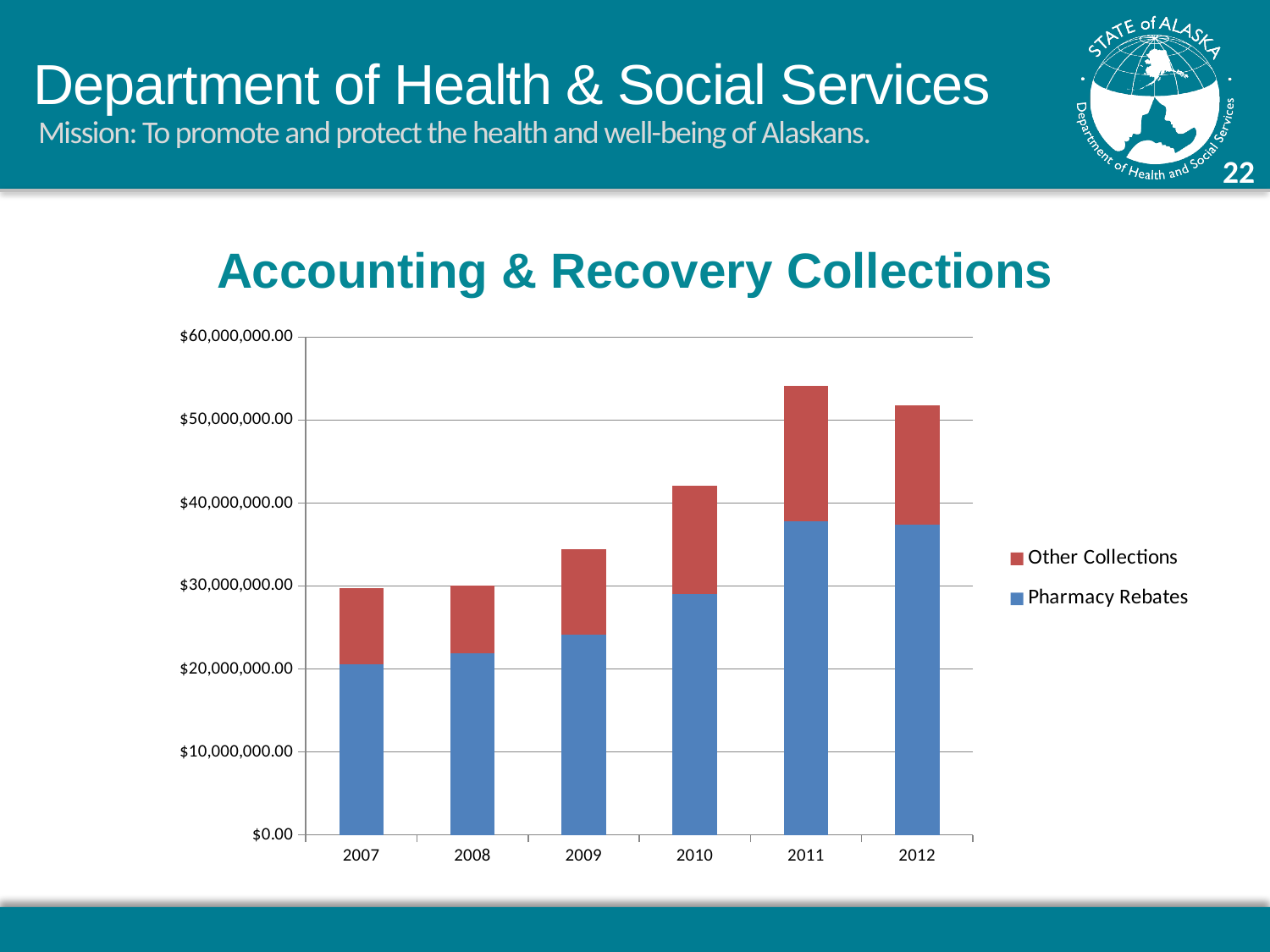
Is the total collections value for 2010 greater or less than $40,000,000.00? greater Is the Pharmacy Rebates value for 2009 greater or less than $30,000,000.00? less Which year has the larger total collections, 2011 or 2012? 2011 How many series does the chart's legend list? 2 Do total collections generally rise or fall from 2007 to 2011? rise How many years are shown on the x axis of the chart? 6 What is the title of the chart? Accounting & Recovery Collections Is the total collections value for 2011 greater or less than $50,000,000.00? greater Which series is shown in blue in the chart? Pharmacy Rebates What kind of chart is shown on the slide? Stacked bar chart Which year has the highest total collections? 2011